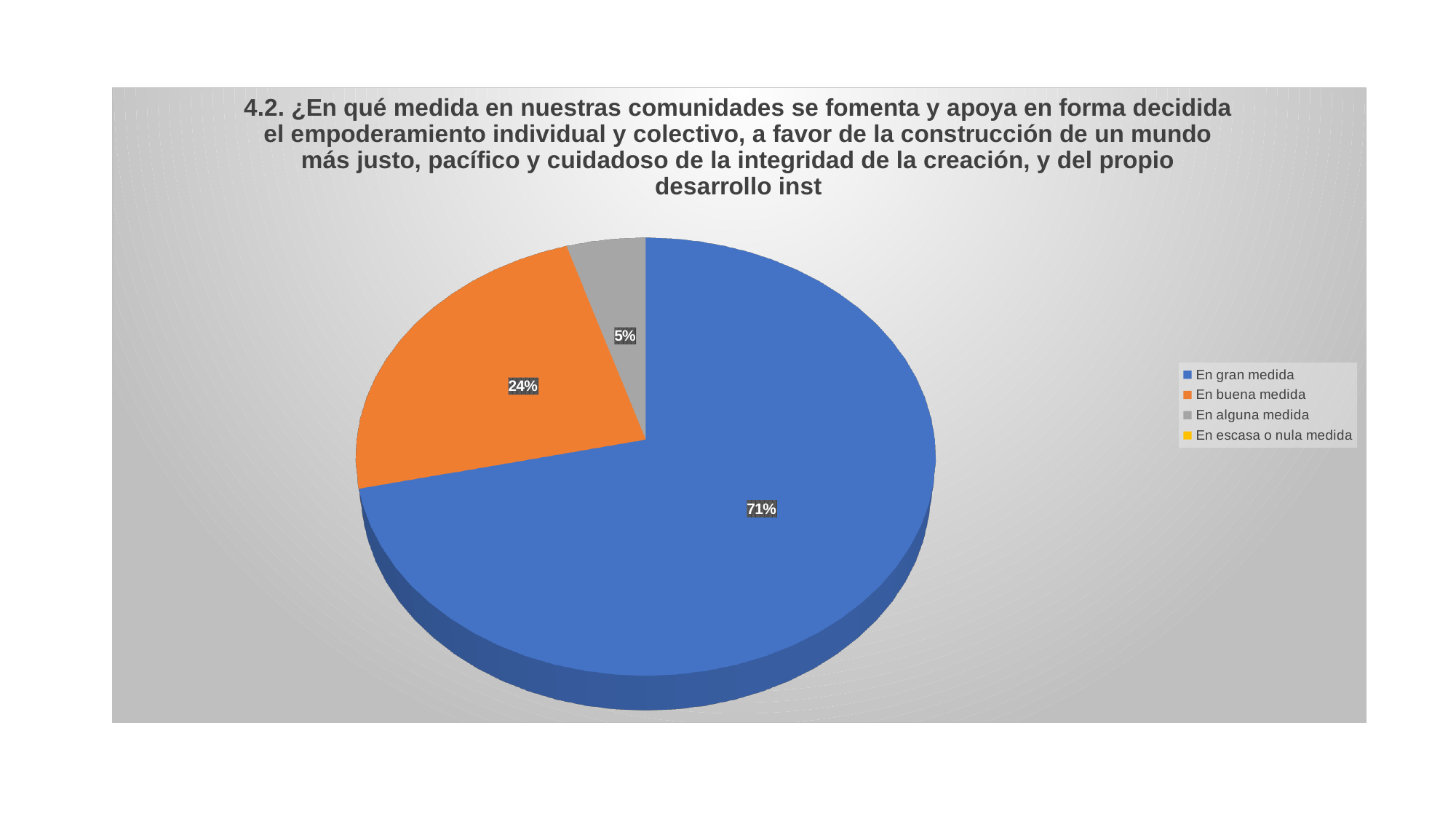
What share of the pie does "En gran medida" represent? 71% What is the difference in percentage points between "En gran medida" and "En buena medida"? 47 How many slices with data labels are visible in the pie? 3 How many entries does the legend list? 4 What kind of chart is shown on the slide? Pie chart What share of the pie does "En buena medida" represent? 24% Which is larger, the share for "En buena medida" or the share for "En alguna medida"? En buena medida What share of the pie does "En alguna medida" represent? 5% What is the difference in percentage points between "En buena medida" and "En alguna medida"? 19 Which category with a visible slice has the smallest share of the pie? En alguna medida Which category has the largest slice of the pie? En gran medida What colour is the slice for "En buena medida"? Orange